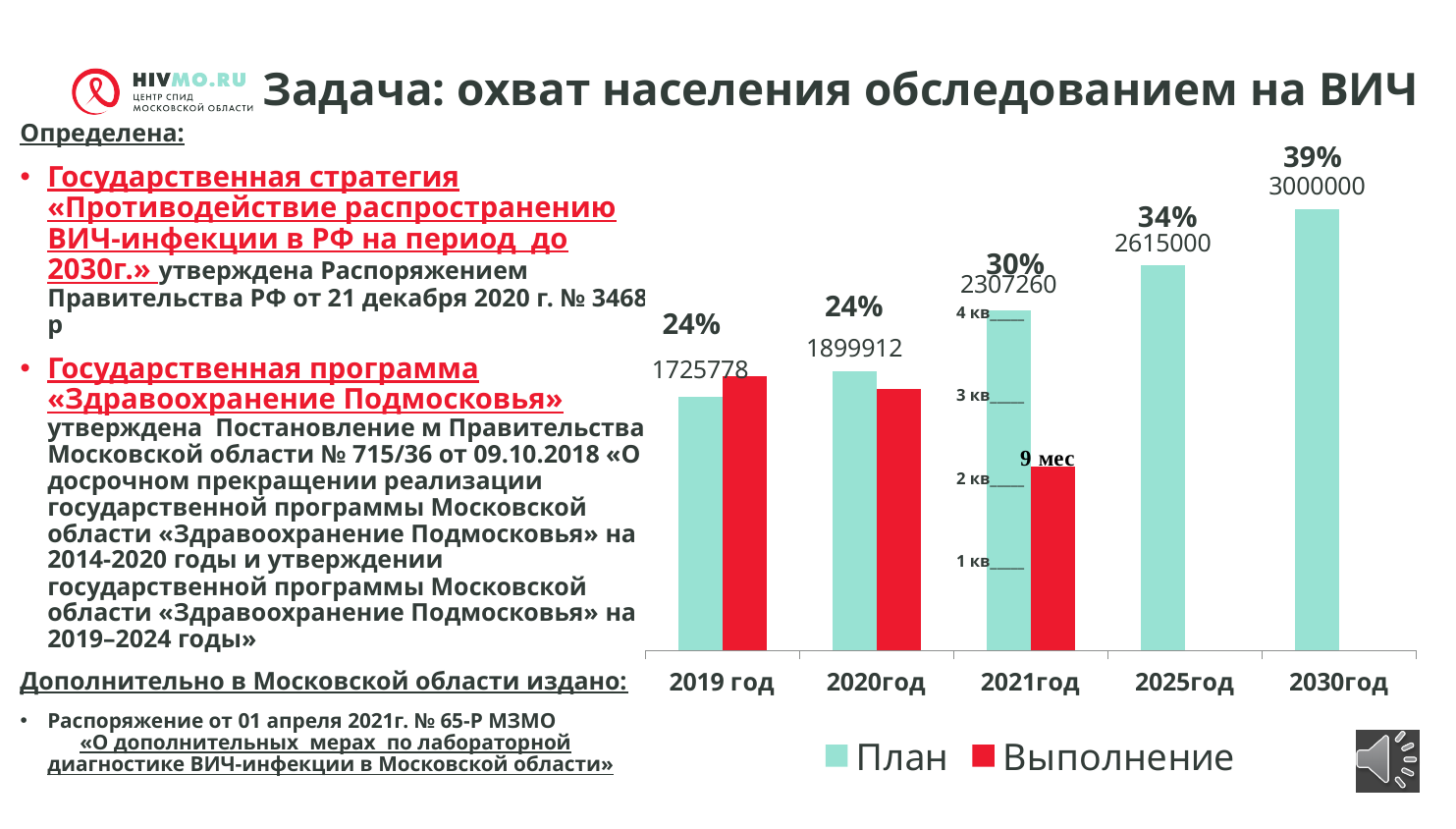
Which year has the highest План value? 2030год What is the План value for 2030год? 3000000 What is the План value for 2019 год? 1725778 What is the difference between the План values for 2030год and 2025год? 385000 Which is larger for 2021год, the План bar or the Выполнение bar? План How many series does the legend list? 2 What kind of chart is shown on the slide? Bar chart What is the План value for 2025год? 2615000 What percentage is shown above the 2021год bars? 30% Do the План values rise or fall from 2019 год to 2030год? Rise Which year has the lowest План value? 2019 год How many year categories are shown on the x axis? 5